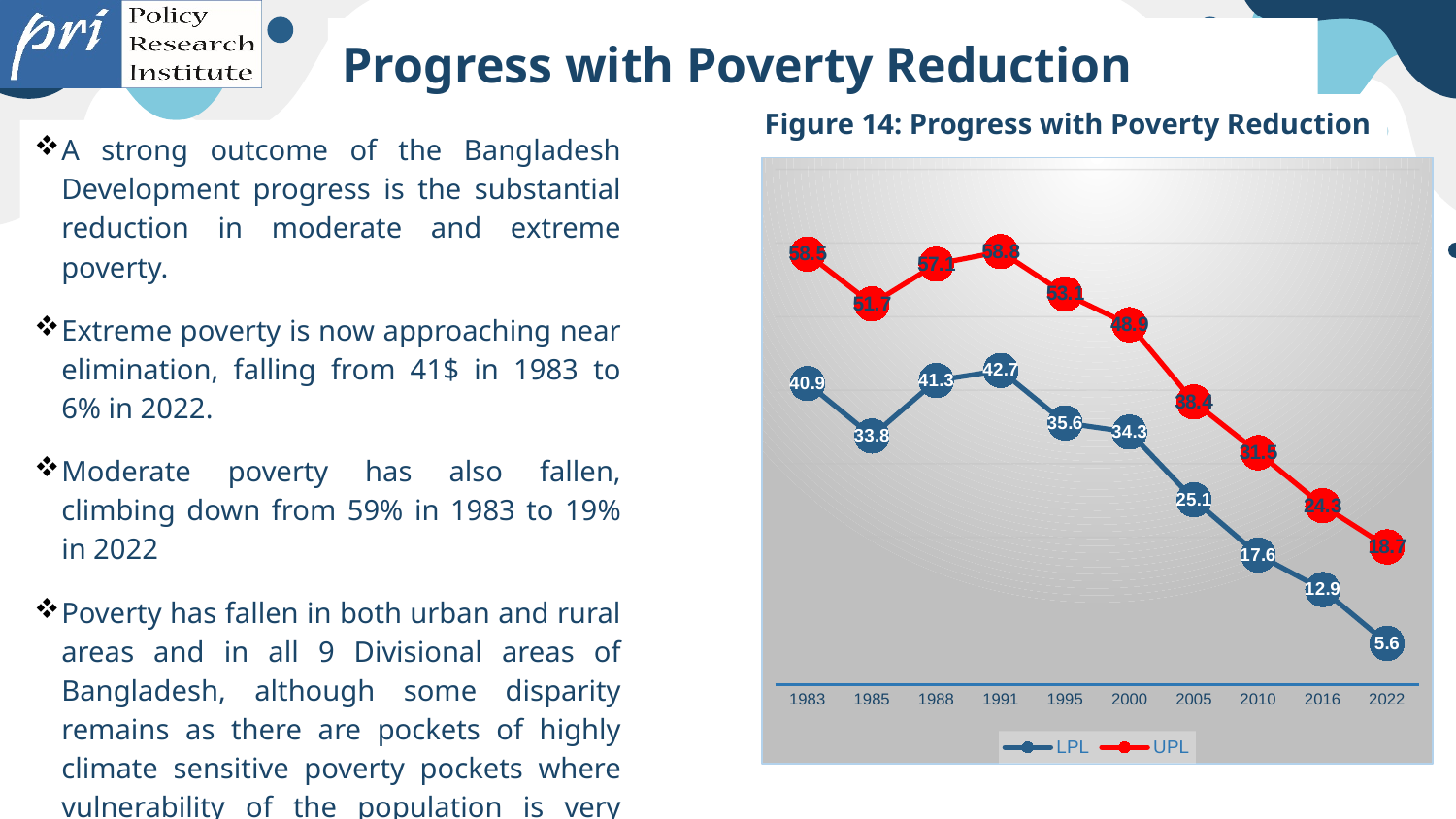
In which year is the LPL series at its highest? 1991 By how much did the LPL value fall from 2010 to 2016? 4.7 What is the UPL value for 2022? 18.7 How many series does the legend list? 2 What is the difference between the UPL and LPL values in 2022? 13.1 What is the UPL value for 2000? 48.9 What is the LPL value for 1991? 42.7 What is the LPL value for 2022? 5.6 What kind of chart is Figure 14? Line chart Which is larger, the UPL value in 1983 or the UPL value in 1991? 1991 In which year is the UPL series at its lowest? 2022 How many years are plotted on the x axis? 10